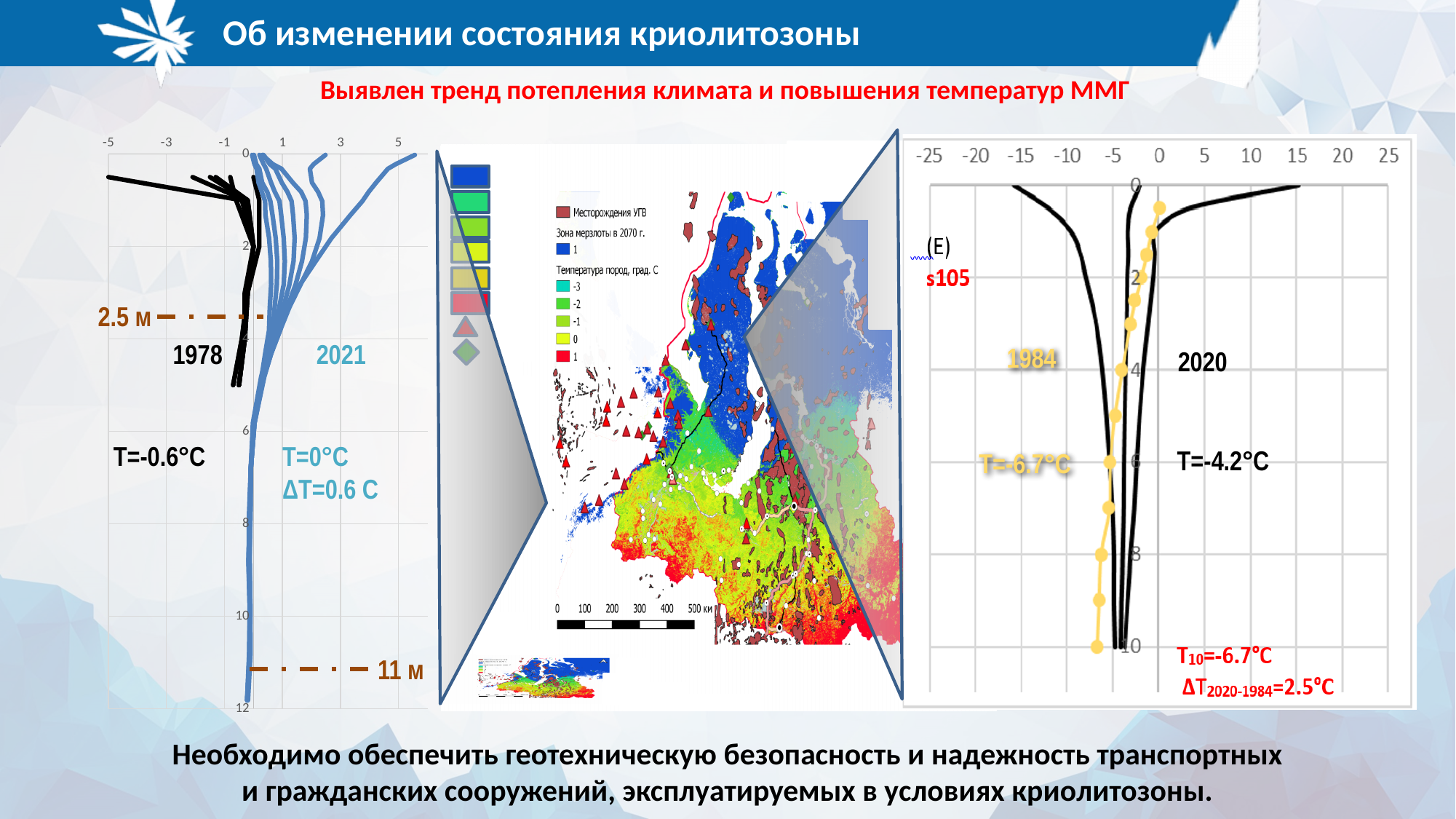
On the left chart, which profile has the higher annotated temperature, 1978 or 2021? 2021 What is the maximum value shown on the horizontal axis of the right chart? 25 On the right chart, what temperature is annotated for the 2020 profile? T=-4.2°C On the left chart, what temperature is annotated for the 1978 profile? T=-0.6°C On the left chart, what depth is marked by the upper dashed brown line? 2.5 м On the right chart, what is the annotated temperature difference ΔT between 2020 and 1984? 2.5°C On the right chart, which profile has the higher annotated temperature, 1984 or 2020? 2020 On the right chart, what temperature is annotated for the 1984 profile? T=-6.7°C On the left chart, what is the annotated temperature change ΔT between 1978 and 2021? ΔT=0.6 C What type of chart is the right chart showing the 1984 and 2020 profiles? Line chart On the left chart, what temperature is annotated for the 2021 profile? T=0°C On the left chart, what depth is marked by the lower dashed brown line? 11 м